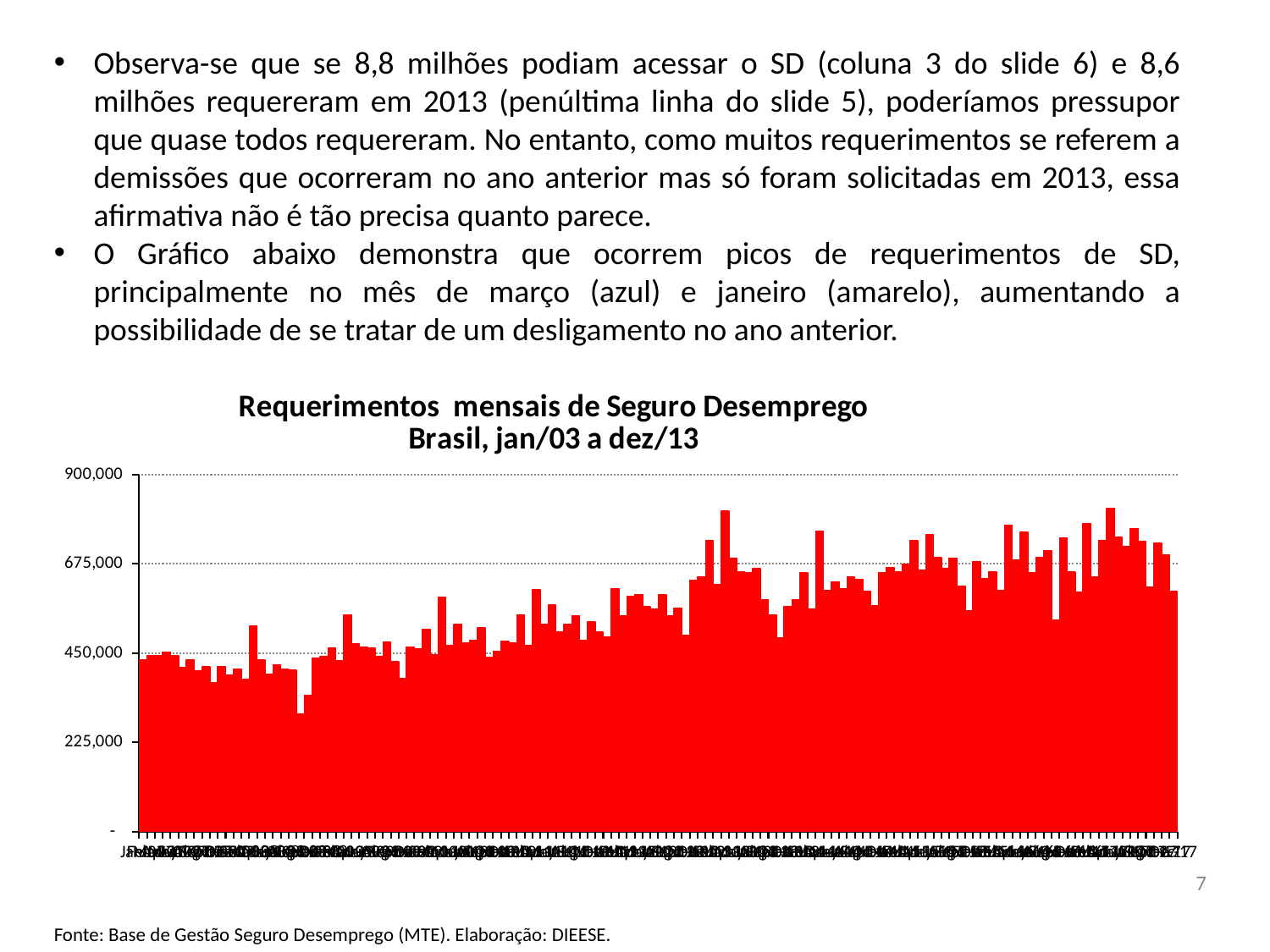
Is the value of the tallest bar greater or less than 675,000? greater Is the value of the first bar on the left greater or less than 675,000? less Overall, do the monthly values rise or fall from the left of the x axis to the right? rise What is the title of the chart? Requerimentos mensais de Seguro Desemprego Brasil, jan/03 a dez/13 What kind of chart is shown on the slide? bar chart Is the value of the tallest bar greater or less than 900,000? less What period does the chart cover, according to its title? jan/03 a dez/13 What is the highest value shown on the y axis? 900,000